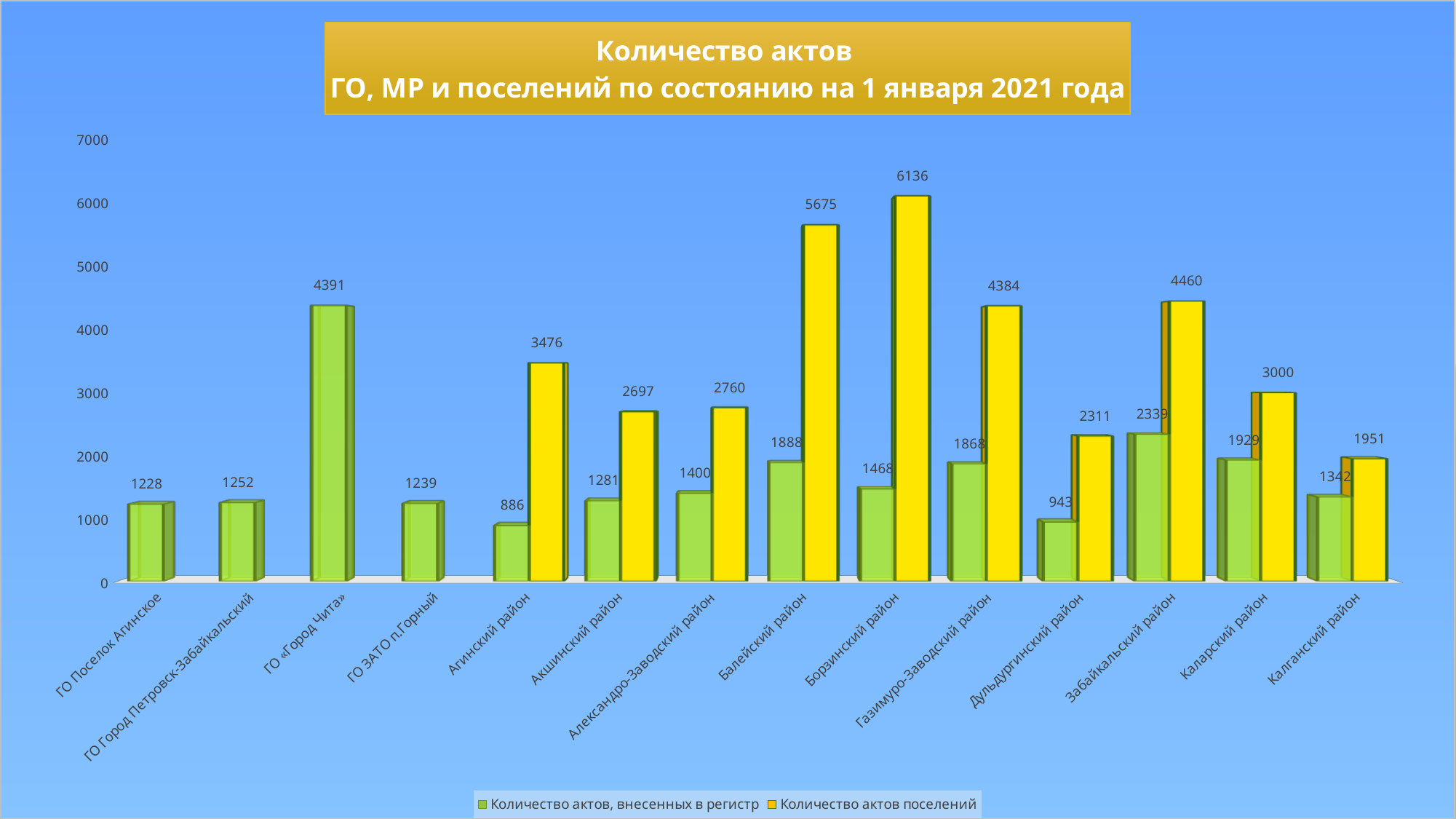
What is the value of "Количество актов поселений" for Борзинский район? 6136 What is the value of "Количество актов, внесенных в регистр" for ГО «Город Чита»? 4391 What is the difference between "Количество актов поселений" and "Количество актов, внесенных в регистр" for Балейский район? 3787 Which category has the highest value for "Количество актов поселений"? Борзинский район Which colour represents "Количество актов поселений" in the legend? yellow What is the value of "Количество актов, внесенных в регистр" for Агинский район? 886 How many series does the legend list? 2 What kind of chart is shown on the slide? bar chart How many categories are shown on the x axis? 14 Is the value of "Количество актов поселений" for Каларский район greater or less than 2000? greater Which is larger: "Количество актов поселений" for Забайкальский район or for Газимуро-Заводский район? Забайкальский район Which category has the lowest value for "Количество актов, внесенных в регистр"? Агинский район